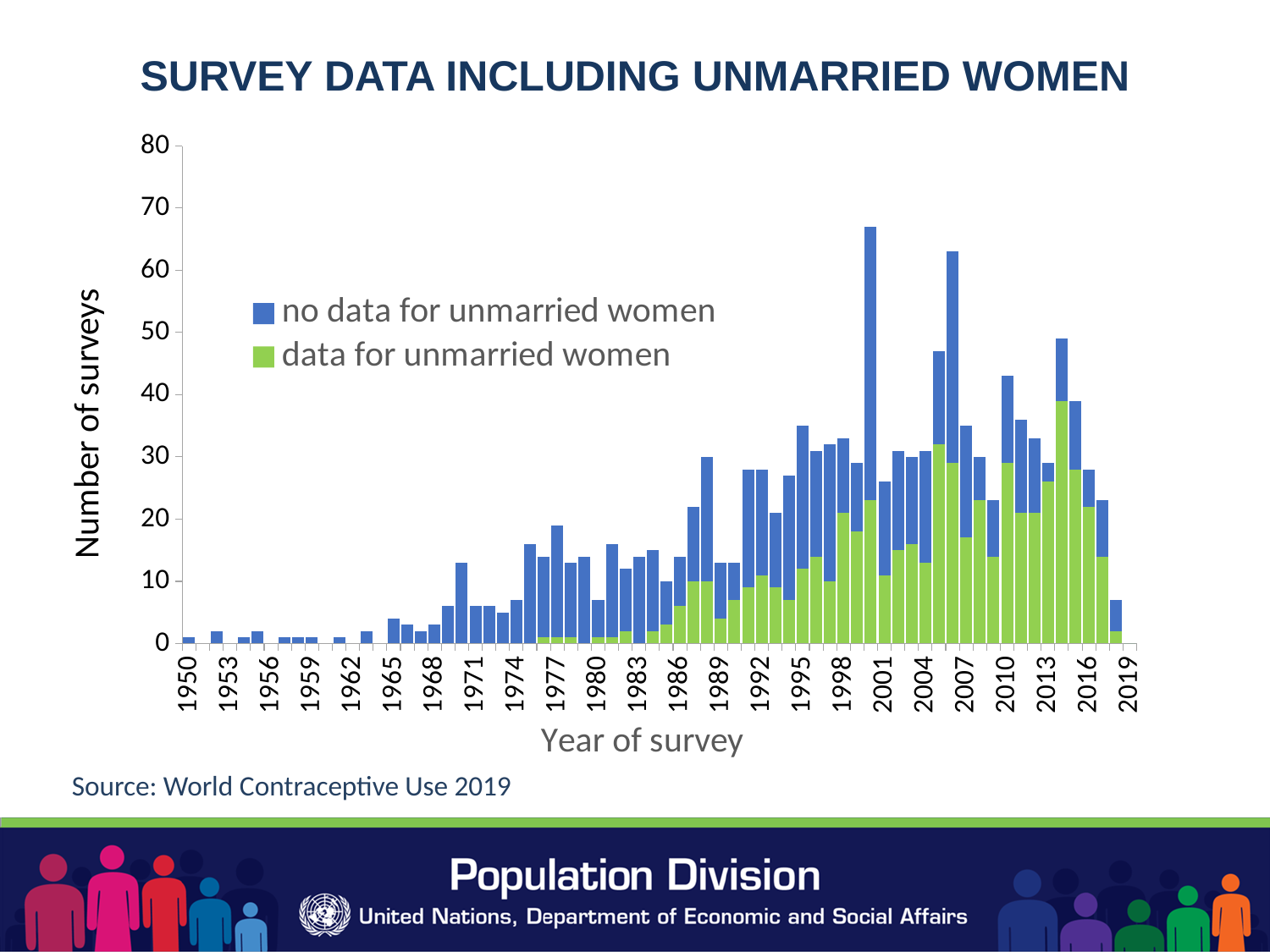
How many series does the legend list? 2 Which year has the tallest total bar? 2000 Do the total number of surveys generally rise or fall from 1950 to the 2000s? rise Which year has a larger total number of surveys, 1950 or 2000? 2000 Is the total number of surveys for 1950 greater or less than 10? less Is the total number of surveys for 2019 greater or less than 10? less What is the title of the chart? SURVEY DATA INCLUDING UNMARRIED WOMEN Which year has a larger 'data for unmarried women' value, 1990 or 2014? 2014 Is the 'data for unmarried women' value for 2014 greater or less than 30? greater What kind of chart is shown on the slide? Stacked bar chart What label is shown on the vertical axis? Number of surveys